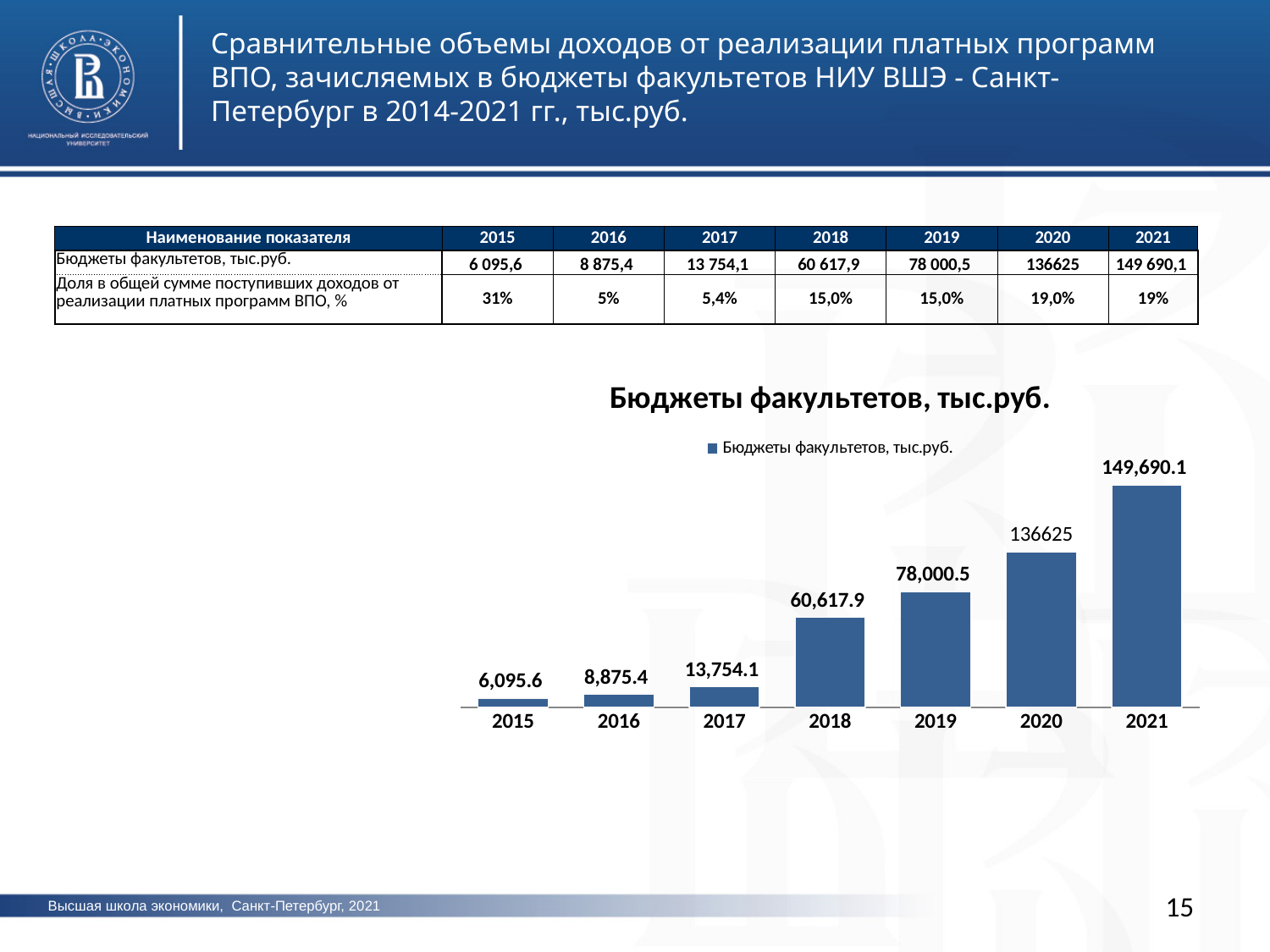
What is the difference between the values for 2021 and 2020? 13,065.1 Which year has the highest value in the chart? 2021 What is the value for 2020 in the chart? 136625 Which is larger, the value for 2017 or the value for 2018? 2018 How many series does the chart legend list? 1 What kind of chart is shown on the slide? bar chart What is the value for 2015 in the chart? 6,095.6 What is the difference between the values for 2019 and 2018? 17,382.6 How many years are shown on the x axis of the chart? 7 Do the values rise or fall from 2015 to 2021? rise What is the value for 2018 in the chart? 60,617.9 Which year has the lowest value in the chart? 2015